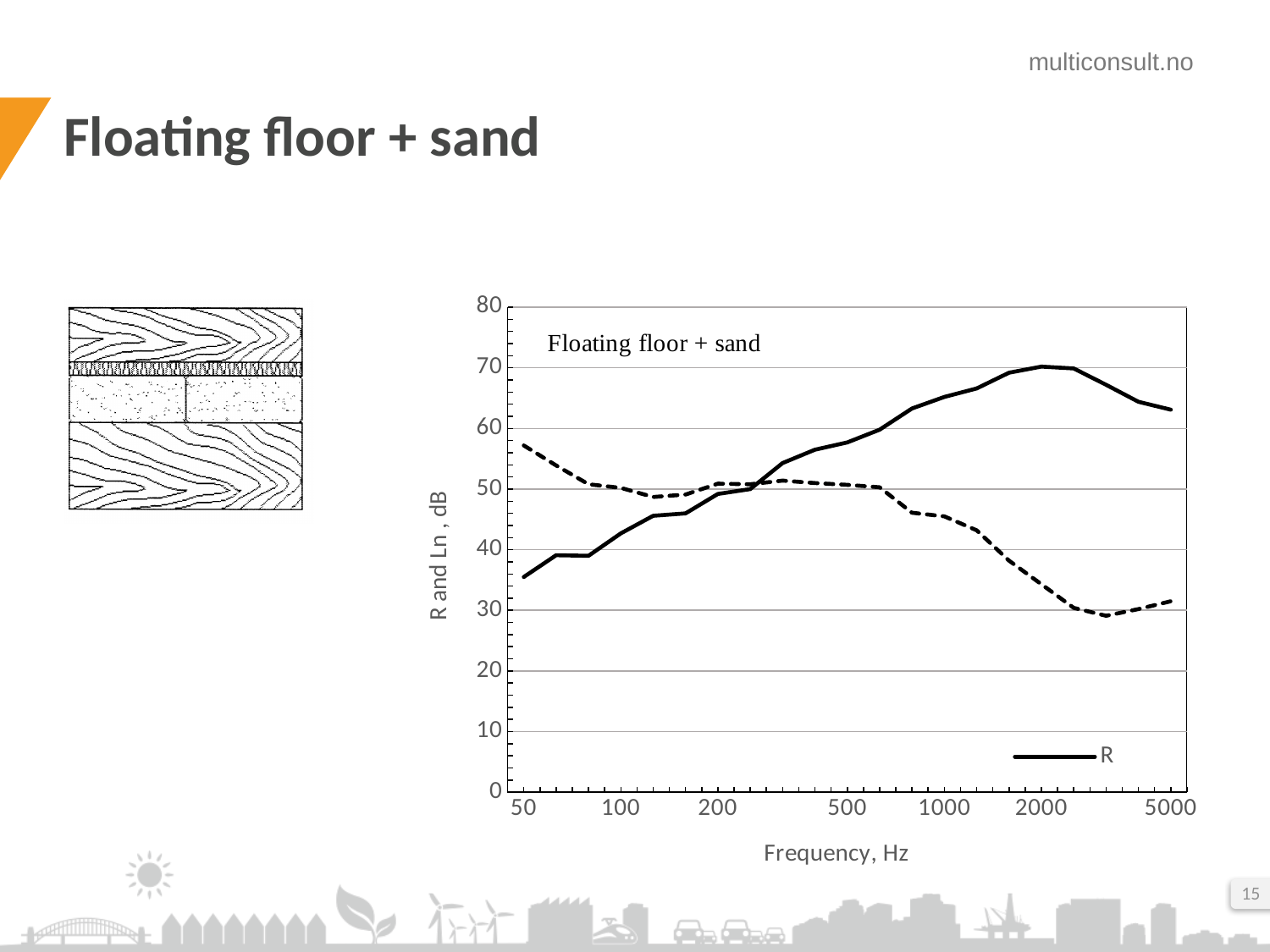
Is the value of the solid R line at 5000 Hz greater or less than 60? greater What kind of chart is shown on the slide? line chart Does the solid R line rise or fall between 50 Hz and 2000 Hz? rise Is the value of the dashed line at 50 Hz greater or less than 50? greater What is the label of the x axis of the chart? Frequency, Hz Is the value of the solid R line at 1000 Hz greater or less than 60? greater What is the title printed inside the chart area? Floating floor + sand How many series does the chart's legend list? 1 At which frequency on the x axis does the solid R line reach its highest value? 2000 Hz At 5000 Hz, which line has the larger value, the solid R line or the dashed line? the solid R line